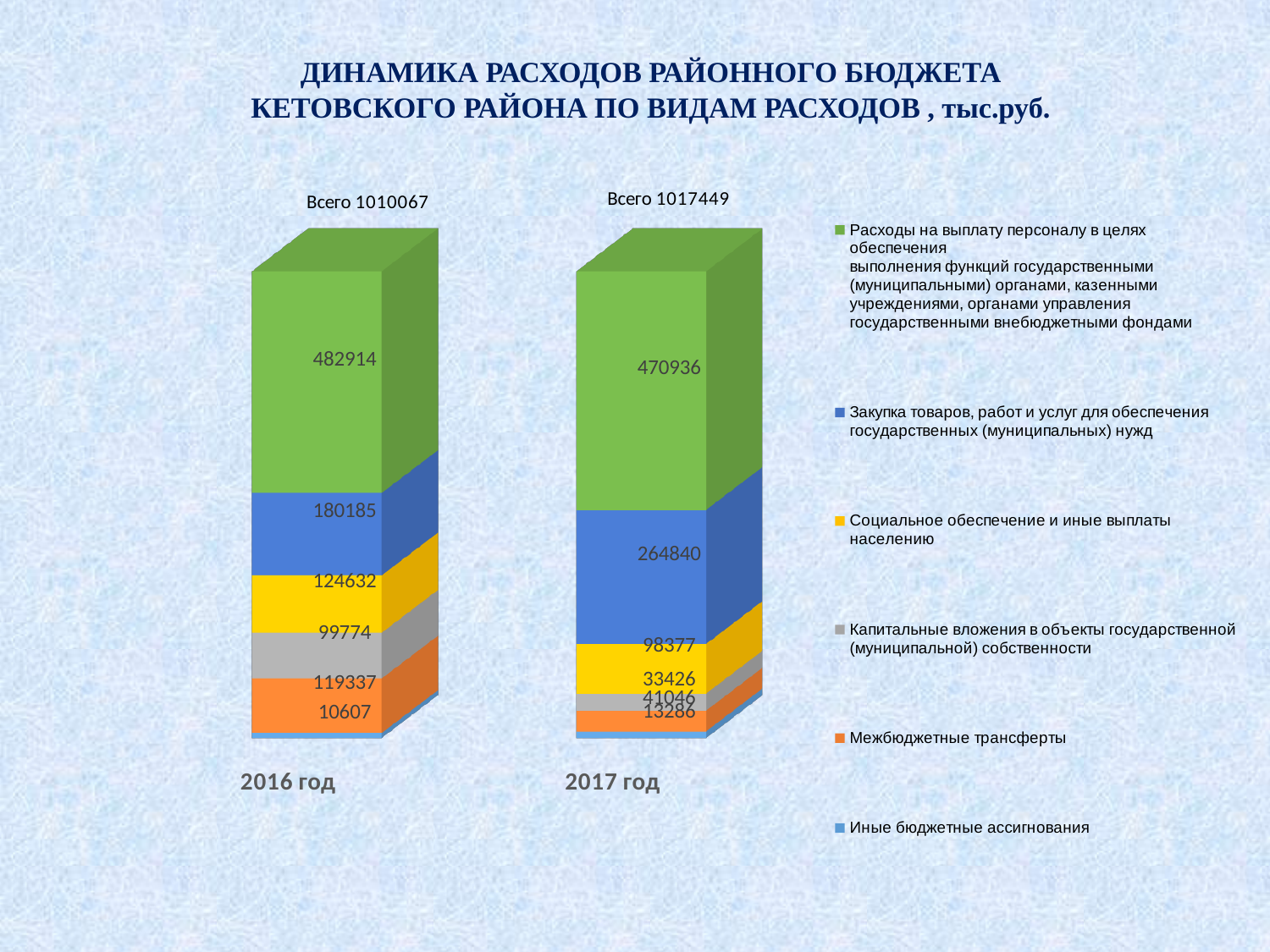
Which expense type is the largest segment in the 2016 год bar? Расходы на выплату персоналу в целях обеспечения выполнения функций государственными (муниципальными) органами, казенными учреждениями, органами управления государственными внебюджетными фондами By how much does the blue segment (Закупка товаров, работ и услуг...) in 2017 год exceed that in 2016 год? 84655 What is the value of the gray segment (Капитальные вложения...) for 2017 год? 33426 Which year has the larger value for the green segment (Расходы на выплату персоналу...), 2016 год or 2017 год? 2016 год What is the value of the blue segment (Закупка товаров, работ и услуг...) for 2017 год? 264840 What kind of chart is shown on the slide? stacked bar chart What total (Всего) is printed above the 2017 год bar? 1017449 What colour represents Социальное обеспечение и иные выплаты населению in the legend? yellow How many bars (years) are plotted in the chart? 2 What is the value of the green segment (Расходы на выплату персоналу...) for 2016 год? 482914 How many series does the legend list? 6 What is the value of the yellow segment (Социальное обеспечение и иные выплаты населению) for 2016 год? 124632